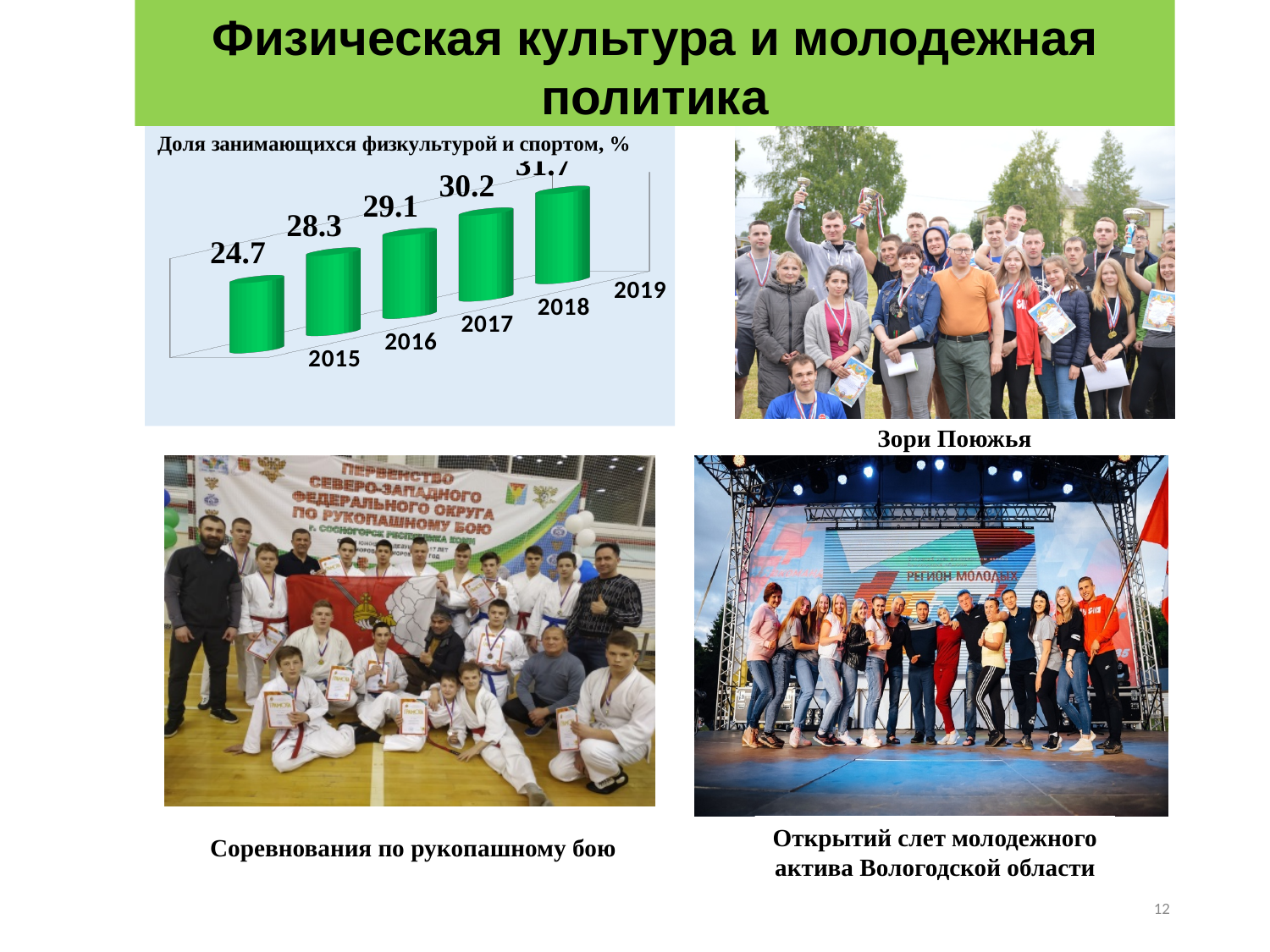
Which year has the lowest value in the chart 'Доля занимающихся физкультурой и спортом, %'? 2015 Which year has the highest value in the chart 'Доля занимающихся физкультурой и спортом, %'? 2019 In the chart 'Доля занимающихся физкультурой и спортом, %', what is the difference between the values for 2016 and 2015? 3.6 Do the values in the chart 'Доля занимающихся физкультурой и спортом, %' rise or fall from 2015 to 2019? rise What is the value for 2017 in the chart 'Доля занимающихся физкультурой и спортом, %'? 29.1 How many years are shown in the chart 'Доля занимающихся физкультурой и спортом, %'? 5 What is the value for 2018 in the chart 'Доля занимающихся физкультурой и спортом, %'? 30.2 What kind of chart is 'Доля занимающихся физкультурой и спортом, %'? bar chart What is the value for 2015 in the chart 'Доля занимающихся физкультурой и спортом, %'? 24.7 In the chart 'Доля занимающихся физкультурой и спортом, %', what is the difference between the values for 2018 and 2017? 1.1 In the chart 'Доля занимающихся физкультурой и спортом, %', which is larger, the value for 2017 or the value for 2015? 2017 What is the value for 2016 in the chart 'Доля занимающихся физкультурой и спортом, %'? 28.3